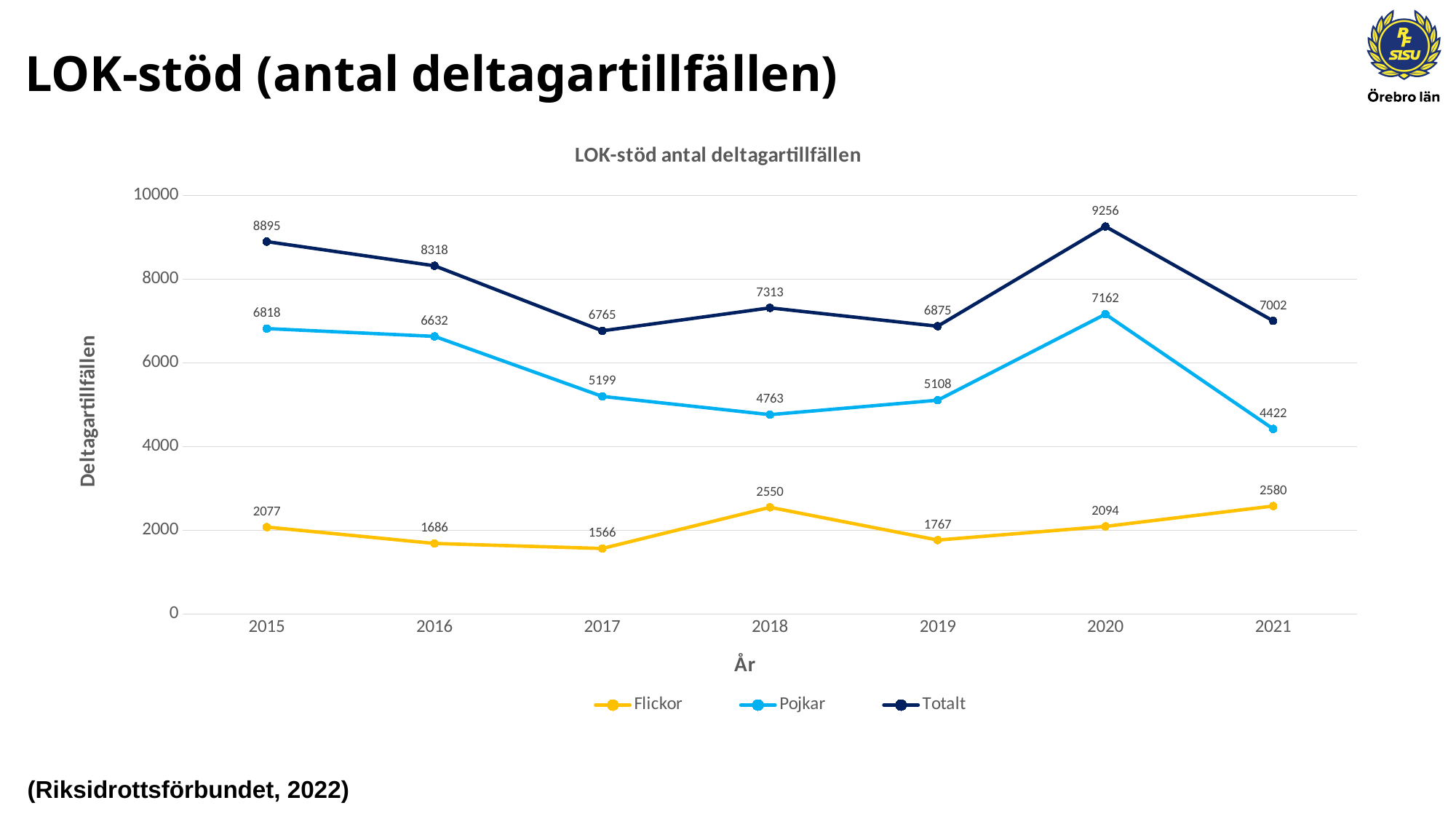
In which year is the Totalt series highest? 2020 What is the difference between the Pojkar values in 2020 and 2021? 2740 In which year is the Flickor series lowest? 2017 Which is larger, the Flickor value in 2015 or the Flickor value in 2021? 2021 What is the value for Totalt in 2020? 9256 How many years are shown on the x axis? 7 Is the value for Pojkar in 2021 greater or less than 6000? less What is the label on the y axis? Deltagartillfällen How many series does the legend list? 3 What is the value for Pojkar in 2017? 5199 What kind of chart is shown? line chart What is the value for Flickor in 2018? 2550